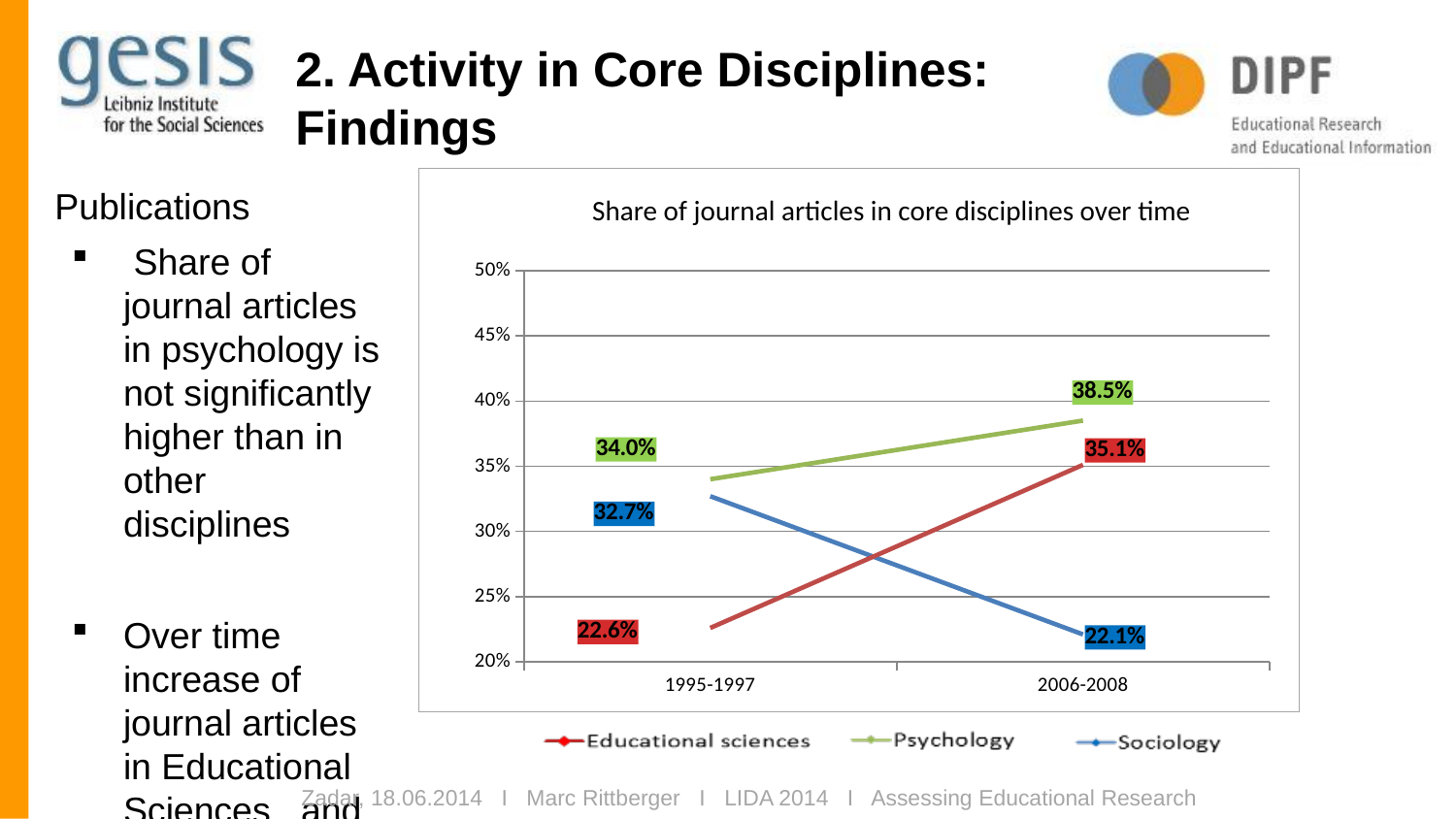
Which discipline has the highest share of journal articles in 1995-1997? Psychology What is the title of the chart? Share of journal articles in core disciplines over time What is the share of journal articles for Educational sciences in 1995-1997? 22.6% How many series does the legend list? 3 Which discipline has the lowest share of journal articles in 2006-2008? Sociology What is the difference between the Psychology share and the Educational sciences share in 2006-2008? 3.4% What is the share of journal articles for Sociology in 2006-2008? 22.1% How many time periods are shown on the x axis? 2 Which is larger in 1995-1997: the share for Sociology or the share for Educational sciences? Sociology What type of chart is shown on the slide? line chart Does the share for Sociology rise or fall from 1995-1997 to 2006-2008? fall What is the share of journal articles for Psychology in 2006-2008? 38.5%